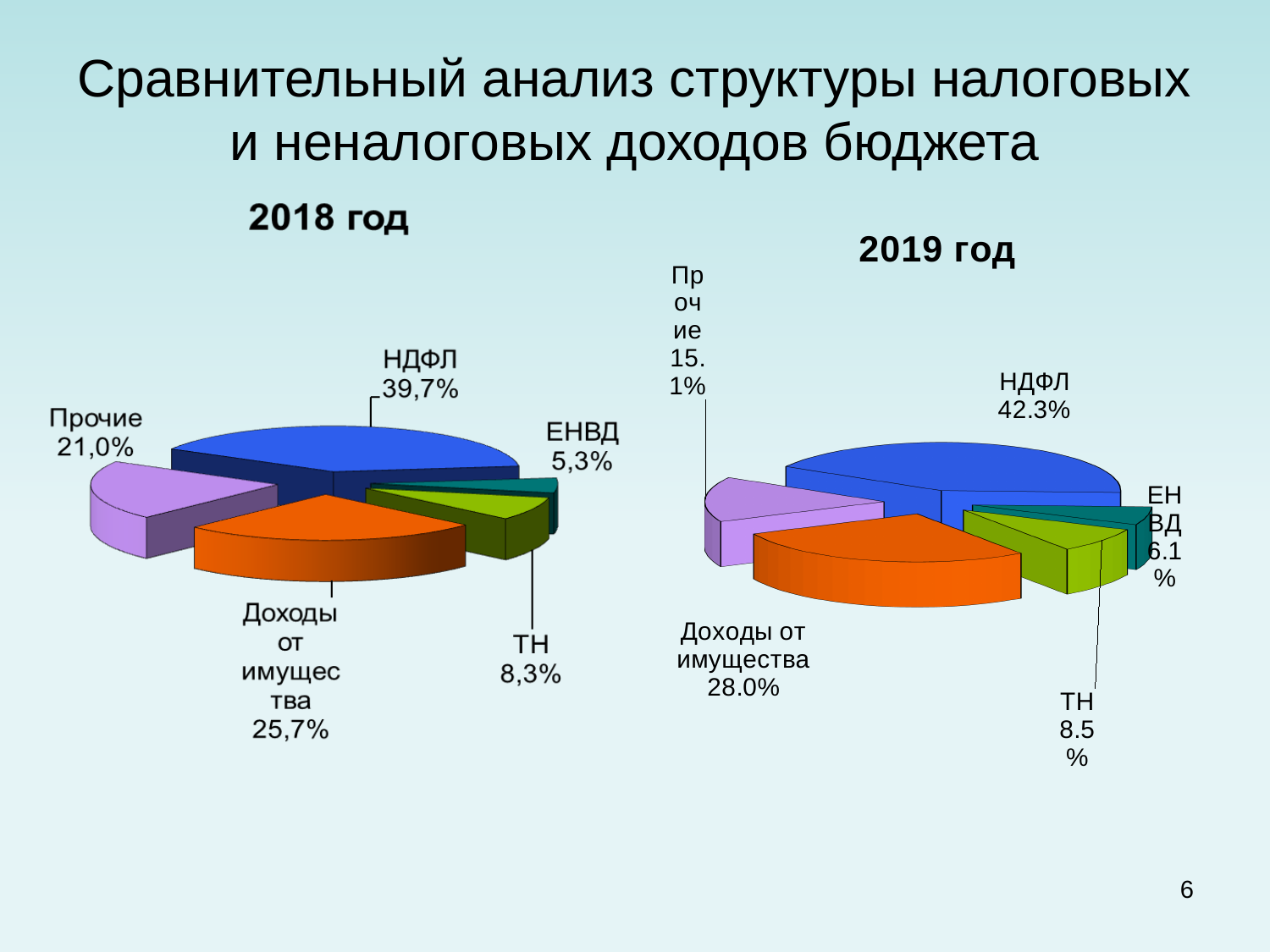
How many slices does the 2018 год chart have? 5 In the 2019 год chart, which category has the smallest slice? ЕНВД In the 2018 год chart, what share does НДФЛ have? 39,7% In the 2018 год chart, which category has the smallest slice? ЕНВД What kind of chart is the 2019 год chart? Pie chart In the 2018 год chart, what is the value for Прочие? 21,0% In the 2019 год chart, what is the value for ЕНВД? 6.1% What is the difference between the НДФЛ share in the 2019 год chart and the НДФЛ share in the 2018 год chart? 2.6 percentage points In the 2018 год chart, what colour is the Доходы от имущества slice? Orange In the 2019 год chart, which is larger: Прочие or Доходы от имущества? Доходы от имущества In the 2019 год chart, what share does Доходы от имущества have? 28.0% In the 2018 год chart, which category has the largest slice? НДФЛ